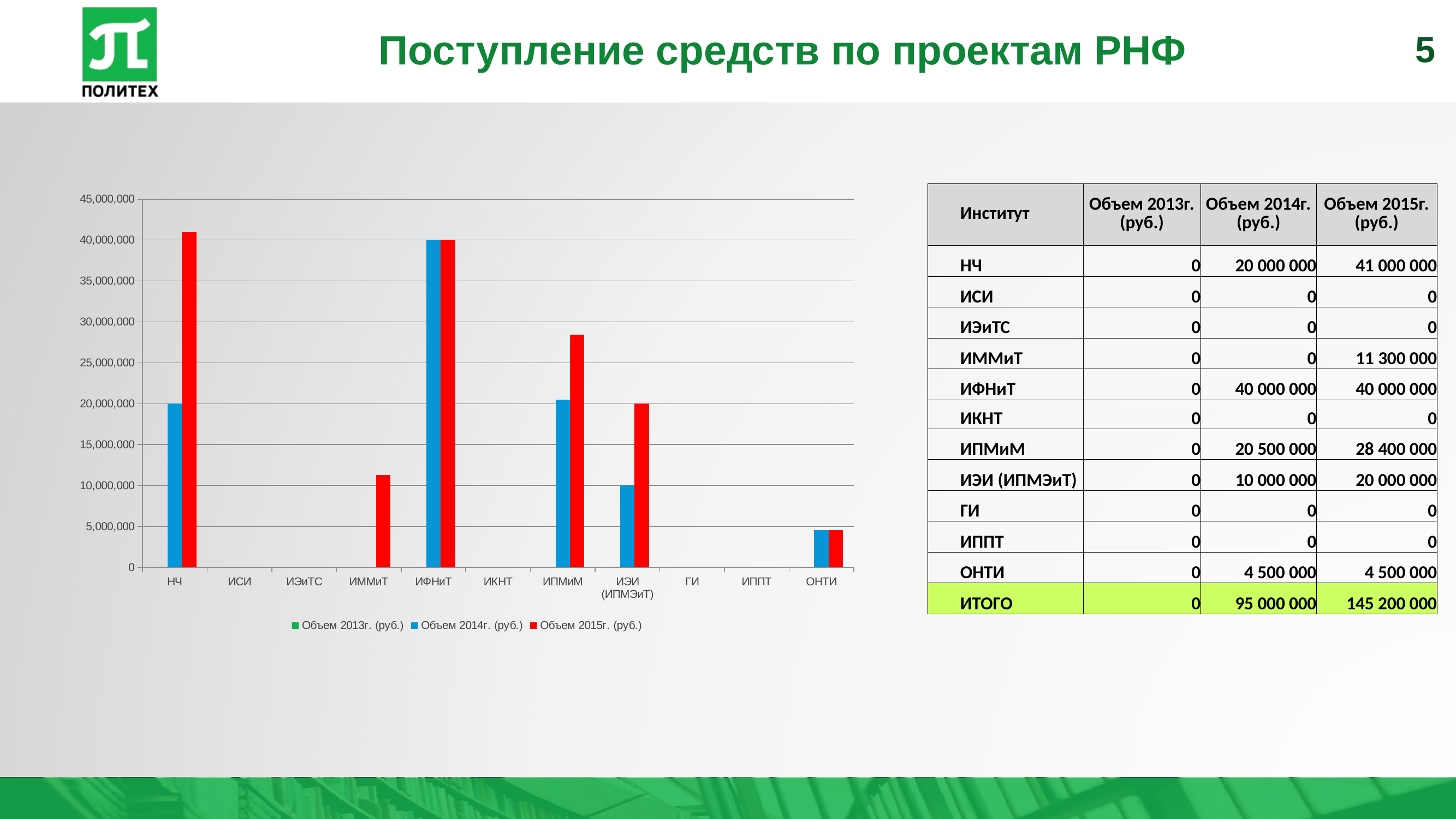
What is the value of Объем 2014г. (руб.) for НЧ? 20,000,000 Which is larger for Объем 2015г. (руб.): ИПМиМ or ИЭИ (ИПМЭиТ)? ИПМиМ Which institute has the highest value for Объем 2015г. (руб.)? НЧ What is the difference between Объем 2015г. and Объем 2014г. for ИПМиМ? 7 900 000 What is the ИТОГО (total) value for Объем 2015г. (руб.) in the table? 145 200 000 What colour represents Объем 2015г. (руб.) in the chart? red What kind of chart is shown on the slide? bar chart How many institutes (categories) are shown on the x axis of the chart? 11 What is the value of Объем 2015г. (руб.) for ИФНиТ? 40,000,000 How many series does the chart legend list? 3 What is the value of Объем 2015г. (руб.) for ИММиТ? 11 300 000 Is the value of Объем 2015г. (руб.) for ИММиТ greater or less than 15,000,000? less